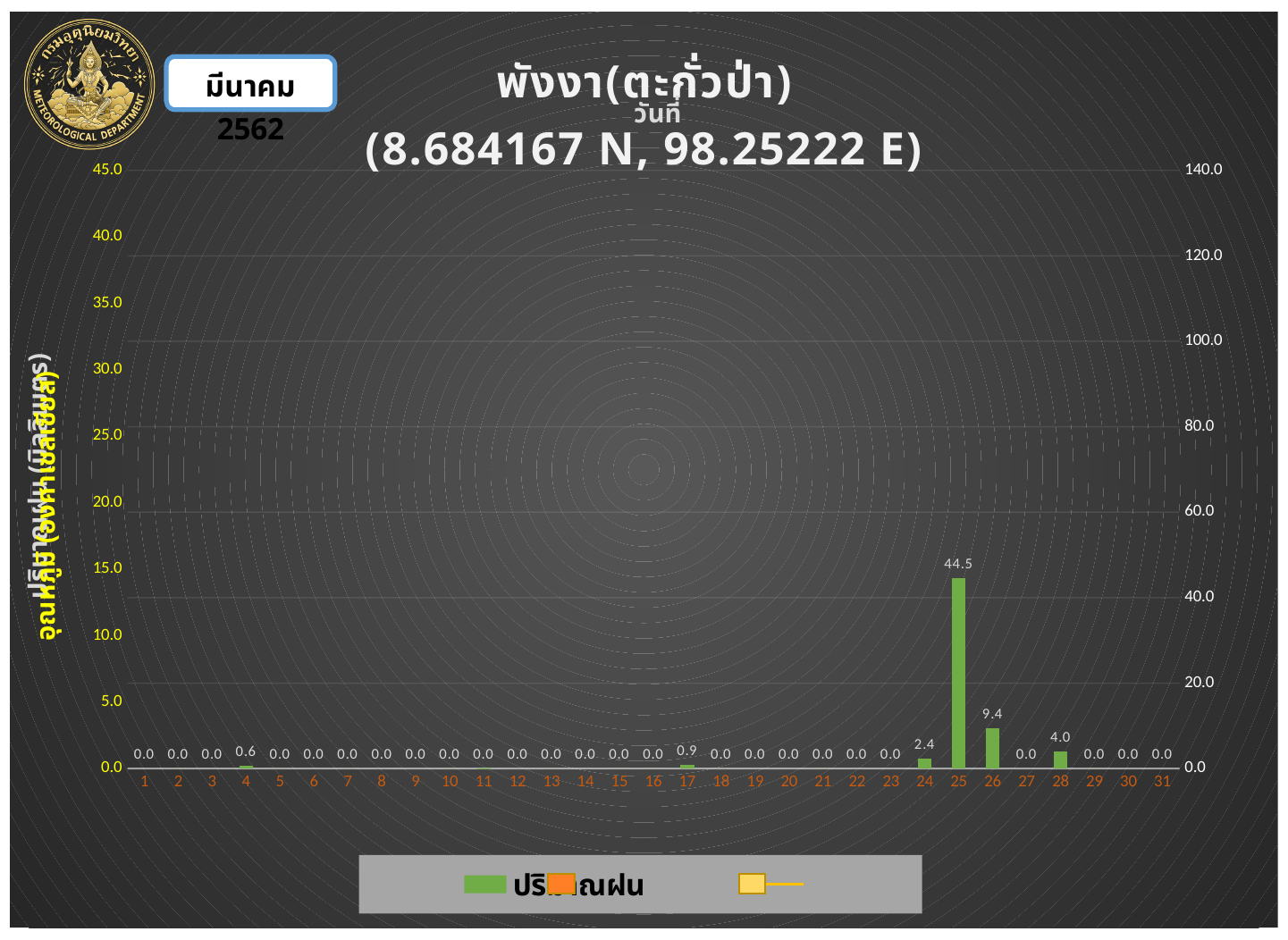
What is the rainfall value on day 17? 0.9 What is the rainfall value on day 28? 4.0 How many days are shown on the x axis? 31 What is the rainfall value on day 26? 9.4 What is the rainfall value on day 4? 0.6 What is the total rainfall for days 24 through 26? 56.3 Which is larger, the rainfall value on day 26 or on day 28? day 26 Which day has the highest rainfall value? 25 What is the rainfall value on day 25? 44.5 What kind of chart is shown? bar chart What is the difference between the rainfall values on day 25 and day 26? 35.1 What is the rainfall value on day 24? 2.4